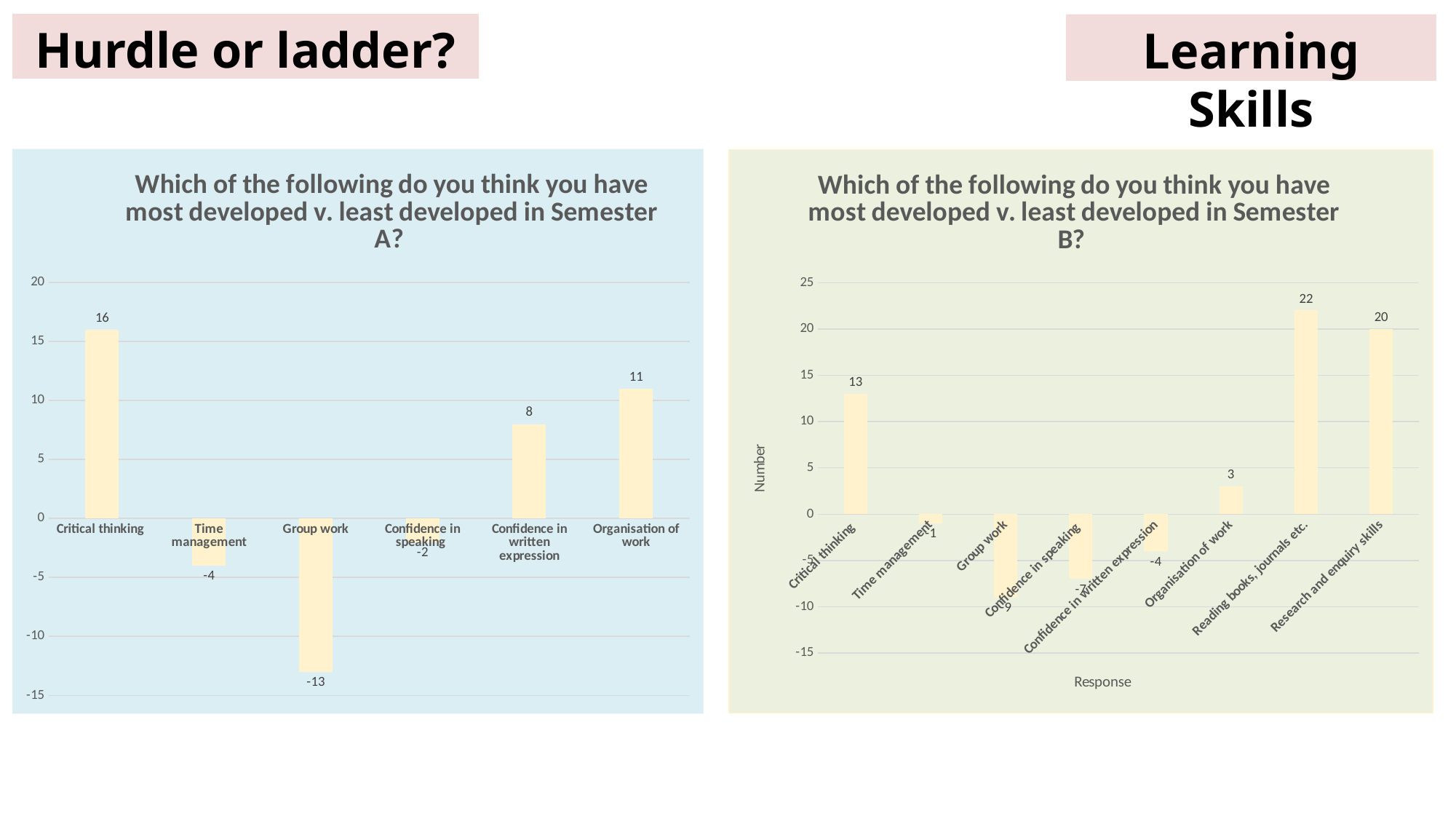
In the Semester B chart on the right, which category has the highest value? Reading books, journals etc. In the Semester B chart on the right, which is larger, the value for Research and enquiry skills or the value for Critical thinking? Research and enquiry skills In the Semester A chart on the left, how many categories are shown on the x axis? 6 In the Semester A chart on the left, what is the value for Critical thinking? 16 In the Semester A chart on the left, what is the difference between the values for Critical thinking and Organisation of work? 5 In the Semester B chart on the right, what is the value for Critical thinking? 13 What type of chart is the Semester B chart on the right? Bar chart In the Semester A chart on the left, which category has the highest value? Critical thinking In the Semester B chart on the right, how many categories are shown on the x axis? 8 In the Semester B chart on the right, what is the value for Reading books, journals etc.? 22 In the Semester A chart on the left, what is the value for Group work? -13 In the Semester A chart on the left, which category has the lowest value? Group work